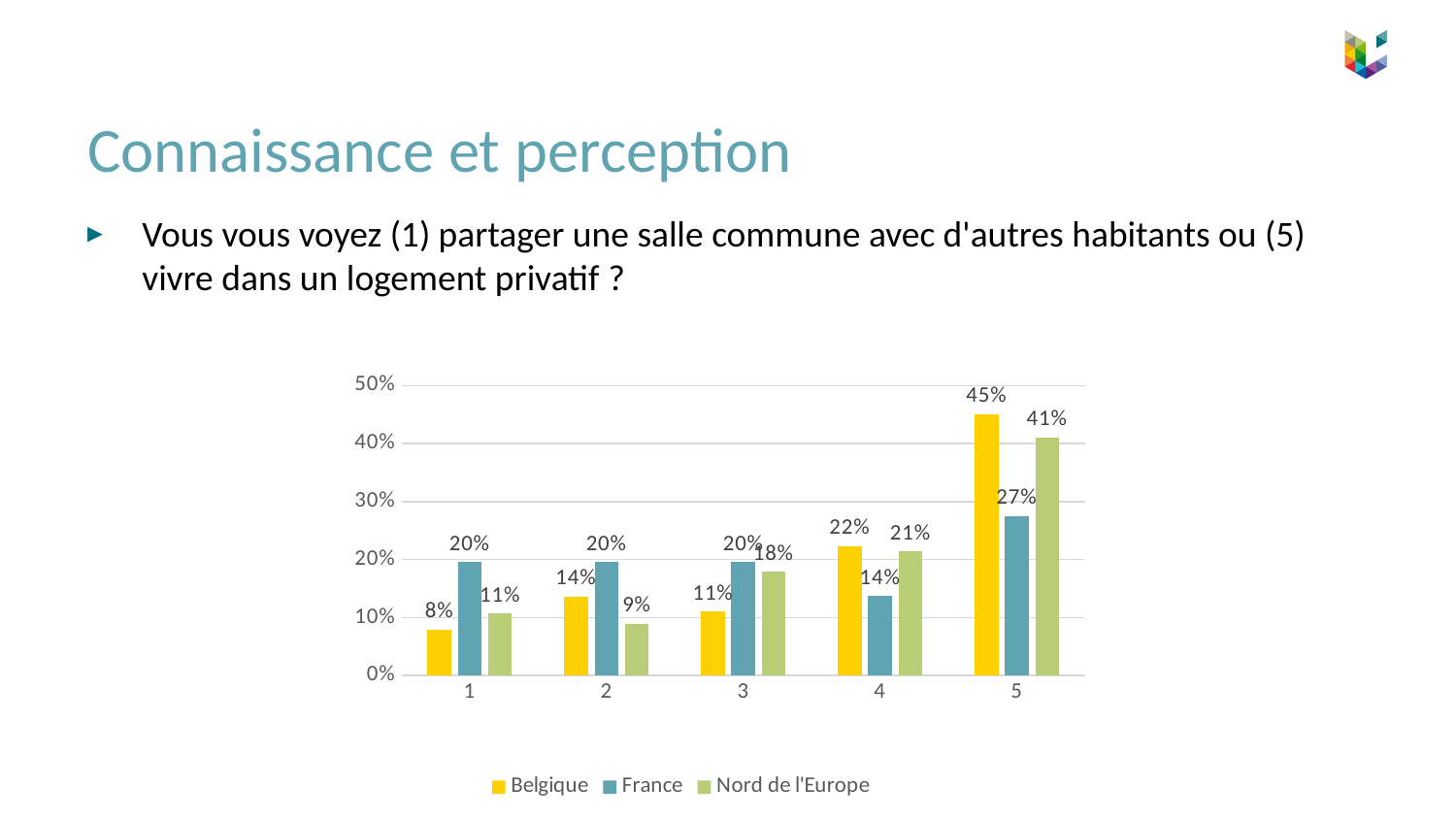
What is the value for France at category 2? 20% What is the value for Nord de l'Europe at category 3? 18% What is the value for Belgique at category 1? 8% How many series does the legend list? 3 What kind of chart is shown on the slide? bar chart For the Belgique series, which category has the highest value? 5 Is the value for Nord de l'Europe at category 5 greater or less than 30%? greater At category 4, which is larger: the value for Belgique or the value for France? Belgique How many categories are shown on the x axis? 5 What is the value for Belgique at category 5? 45% What is the difference between the Belgique and France values at category 5? 18% For the Nord de l'Europe series, which category has the lowest value? 2